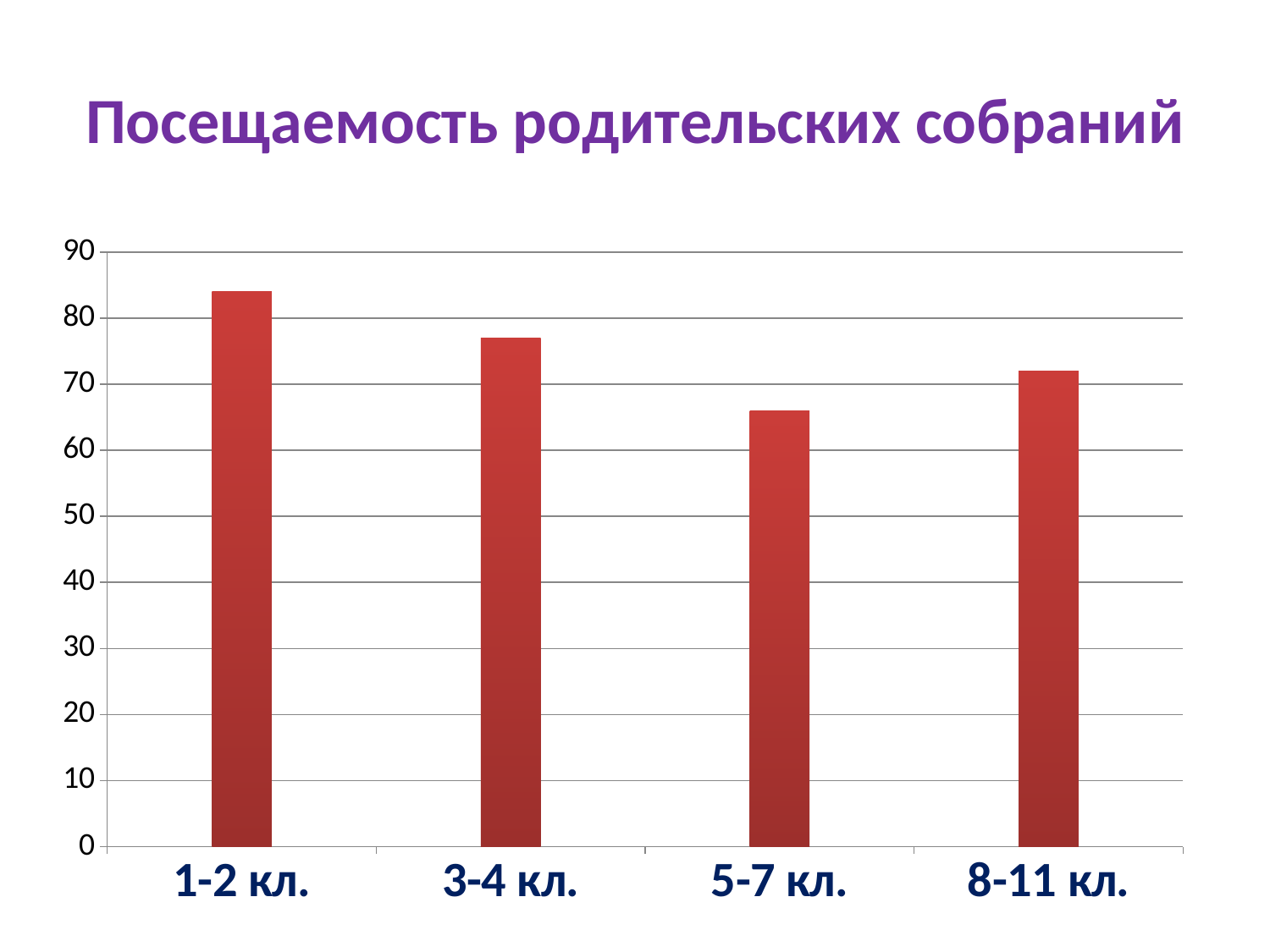
How many categories are shown on the x axis? 4 Which is larger, the value for 5-7 кл. or the value for 8-11 кл.? 8-11 кл. Is the value for 3-4 кл. greater or less than 80? less Is the value for 5-7 кл. greater or less than 70? less Is the value for 8-11 кл. greater or less than 80? less Do the values rise or fall from 1-2 кл. to 5-7 кл.? fall Which category has the lowest value? 5-7 кл. Which category has the highest value? 1-2 кл. What is the title of the chart? Посещаемость родительских собраний Which is larger, the value for 3-4 кл. or the value for 8-11 кл.? 3-4 кл. What kind of chart is shown on the slide? bar chart